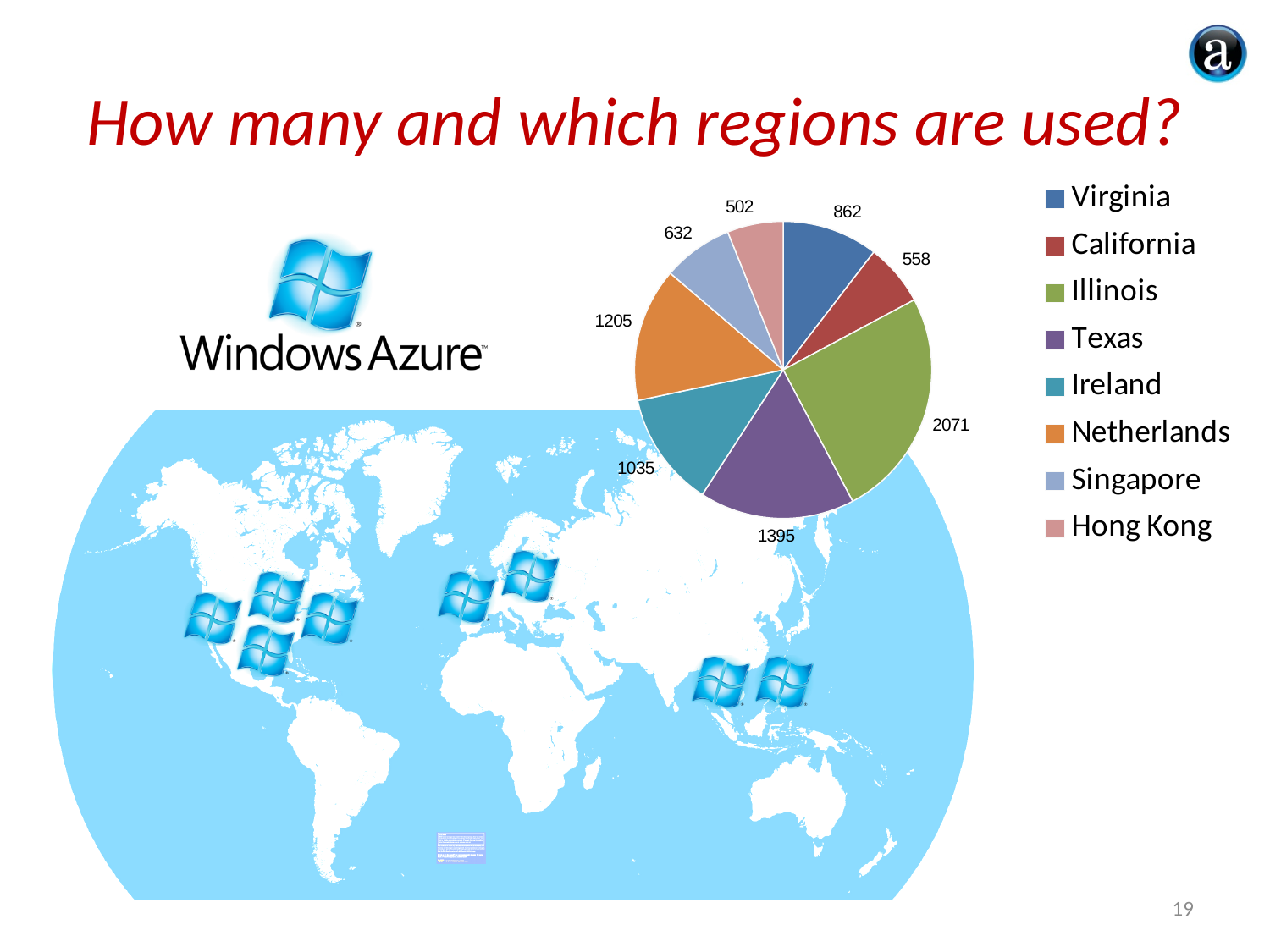
Which region is listed last in the chart legend? Hong Kong What value is shown for Texas in the pie chart? 1395 Which region has the largest slice in the pie chart? Illinois What is the difference between the values for Virginia and California? 304 Which region has the smallest slice in the pie chart? Hong Kong What value is shown for Illinois in the pie chart? 2071 What kind of chart is shown on the slide? Pie chart Which has a larger value, Ireland or Netherlands? Netherlands What value is shown for Hong Kong in the pie chart? 502 How many regions are shown in the pie chart? 8 What value is shown for Netherlands in the pie chart? 1205 What is the difference between the values for Illinois and Texas? 676